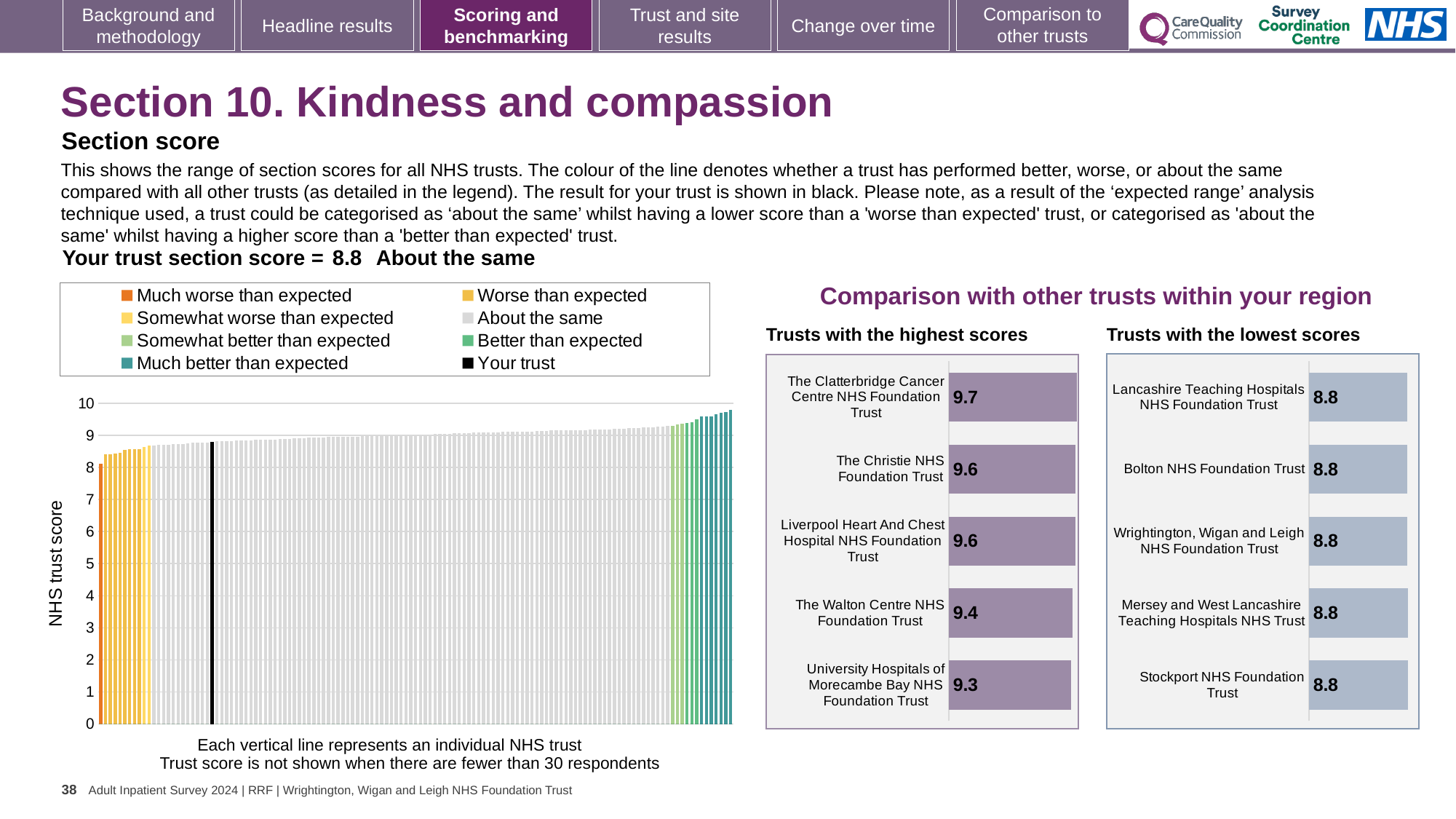
In the 'Trusts with the highest scores' chart, what is the score for The Clatterbridge Cancer Centre NHS Foundation Trust? 9.7 In the 'Trusts with the lowest scores' chart, what is the score for Bolton NHS Foundation Trust? 8.8 In the 'Trusts with the lowest scores' chart, how many trusts are listed? 5 How many entries does the legend of the large chart on the left list? 8 In the large chart on the left, do the trust scores rise or fall from left to right along the x axis? Rise What kind of chart is the large chart on the left showing NHS trust scores? Bar chart In the 'Trusts with the lowest scores' chart, what is the score for Stockport NHS Foundation Trust? 8.8 In the 'Trusts with the highest scores' chart, how many trusts are shown? 5 In the 'Trusts with the highest scores' chart, which trust has the highest score? The Clatterbridge Cancer Centre NHS Foundation Trust In the 'Trusts with the highest scores' chart, what is the score for The Walton Centre NHS Foundation Trust? 9.4 In the 'Trusts with the highest scores' chart, what is the difference between the scores of The Clatterbridge Cancer Centre NHS Foundation Trust and University Hospitals of Morecambe Bay NHS Foundation Trust? 0.4 In the 'Trusts with the highest scores' chart, which trust has the lowest score? University Hospitals of Morecambe Bay NHS Foundation Trust